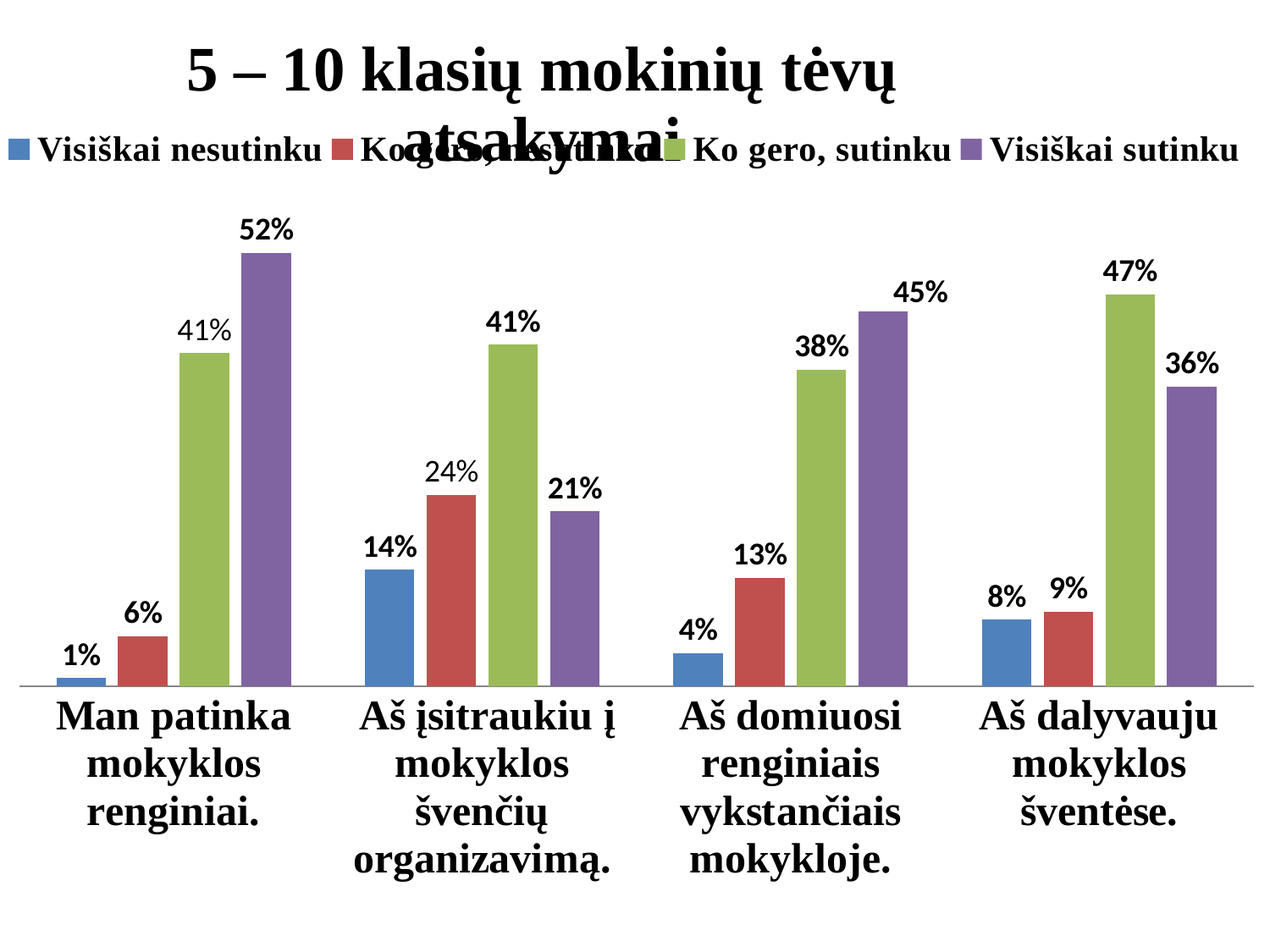
How many categories are shown on the x axis of the chart? 4 What is the value of "Visiškai sutinku" for "Man patinka mokyklos renginiai."? 52% Which series is shown in green in the legend? Ko gero, sutinku What is the value of "Visiškai nesutinku" for "Aš įsitraukiu į mokyklos švenčių organizavimą."? 14% What kind of chart is shown on the slide? Bar chart Which category has the highest value for "Visiškai sutinku"? Man patinka mokyklos renginiai. How many series does the legend list? 4 For "Aš dalyvauju mokyklos šventėse.", which is larger: "Ko gero, sutinku" or "Visiškai sutinku"? Ko gero, sutinku What is the value of "Visiškai sutinku" for "Aš domiuosi renginiais vykstančiais mokykloje."? 45% Which category has the lowest value for "Visiškai nesutinku"? Man patinka mokyklos renginiai. What is the value of "Ko gero, sutinku" for "Aš dalyvauju mokyklos šventėse."? 47% What is the difference between "Visiškai sutinku" and "Ko gero, sutinku" for "Aš domiuosi renginiais vykstančiais mokykloje."? 7%